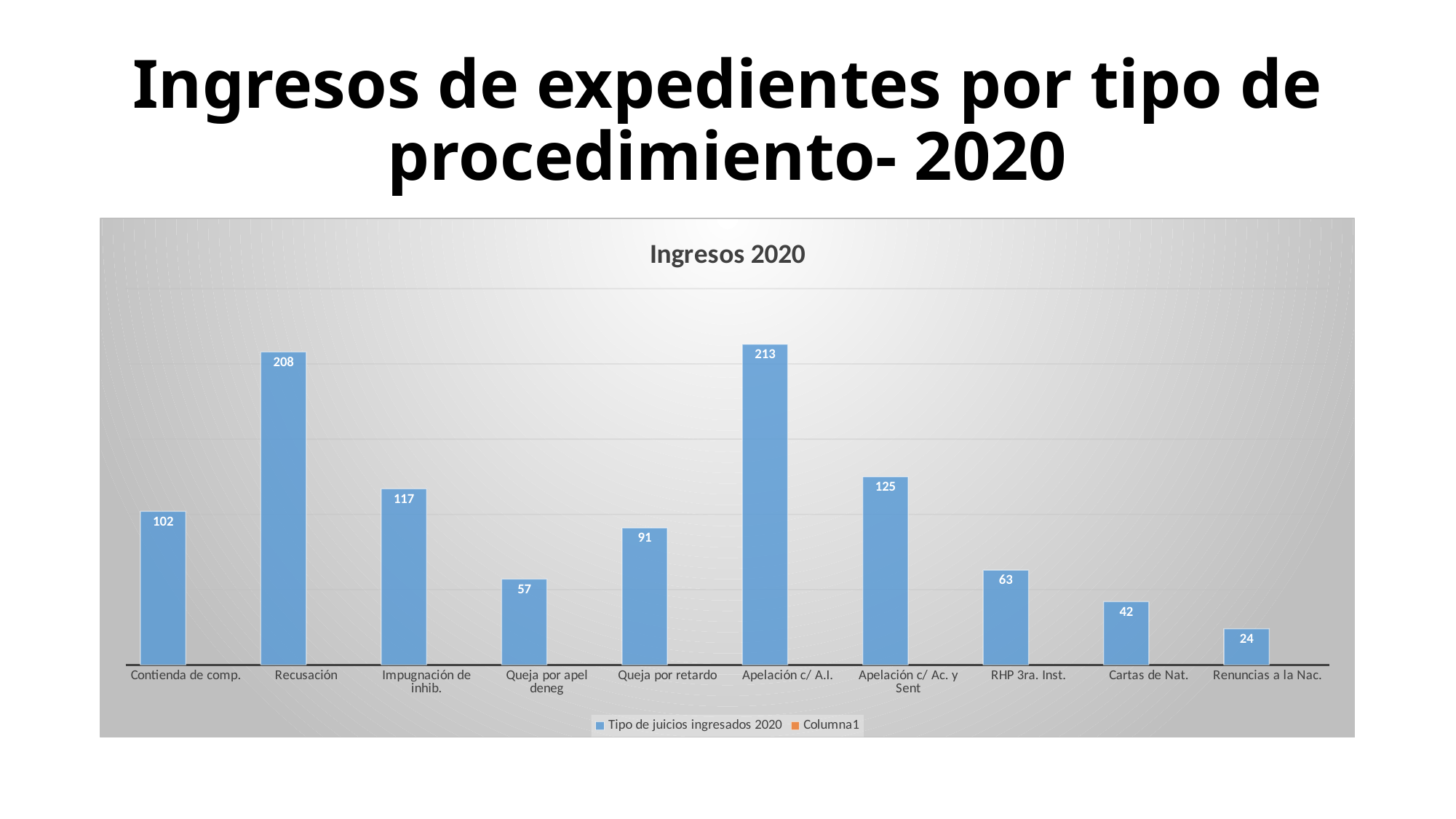
How many categories are shown on the x axis? 10 What is the value for Cartas de Nat.? 42 What is the title of the chart? Ingresos 2020 What is the difference between the values for Apelación c/ A.I. and Recusación? 5 Which is larger, the value for Contienda de comp. or the value for Apelación c/ Ac. y Sent? Apelación c/ Ac. y Sent What is the difference between the values for Impugnación de inhib. and Queja por apel deneg? 60 Which category has the highest value? Apelación c/ A.I. What is the value for Queja por retardo? 91 What is the value for Recusación? 208 How many series does the legend list? 2 What kind of chart is shown? bar chart Which category has the lowest value? Renuncias a la Nac.